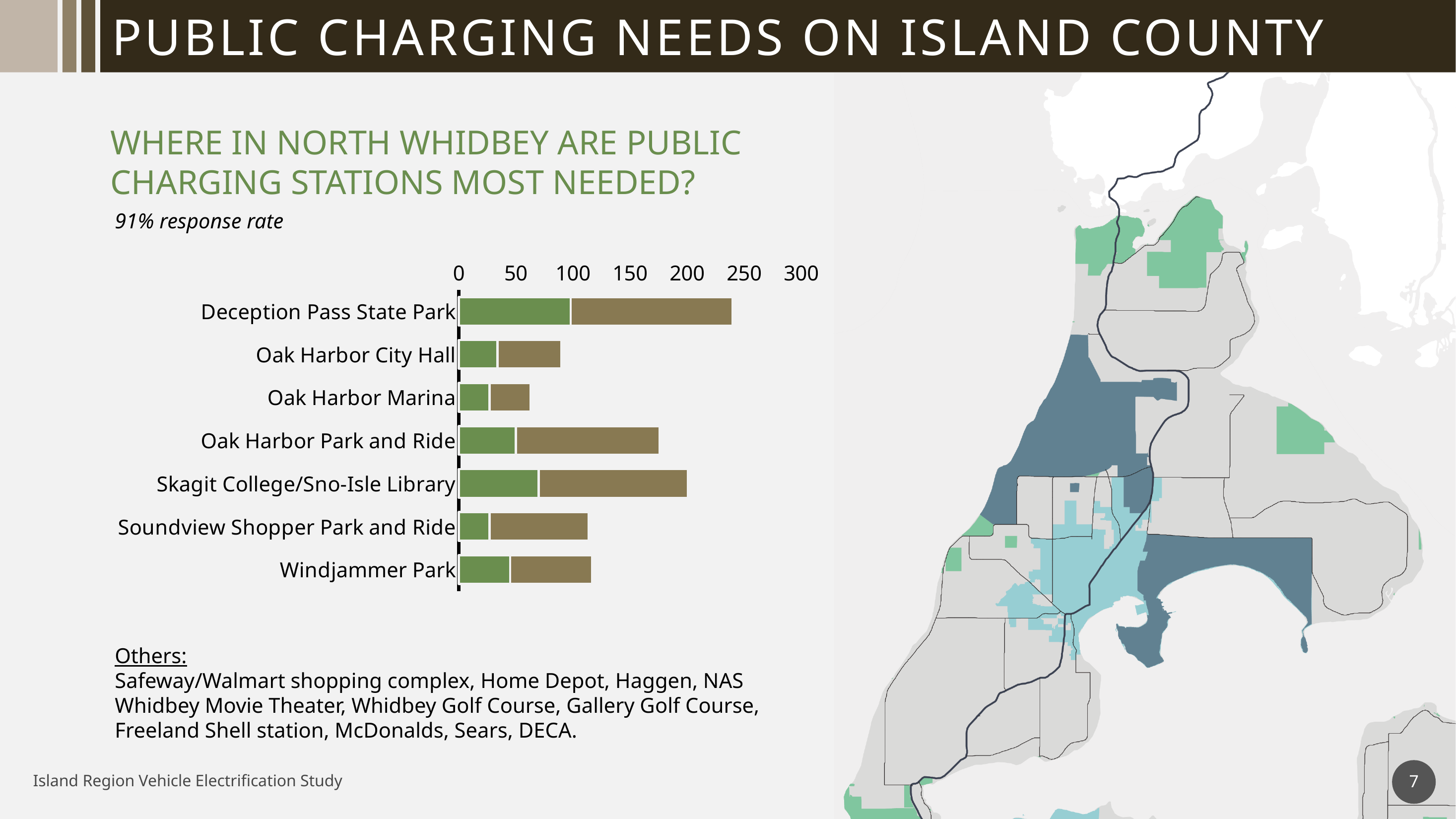
Is the total bar length for Oak Harbor City Hall greater or less than 100? less What response rate is stated below the chart's question heading? 91% response rate How many locations are listed on the chart? 7 Is the total bar length for Deception Pass State Park greater or less than 200? greater Which location has the shortest bar on the chart? Oak Harbor Marina Which location has the longest bar on the chart? Deception Pass State Park What kind of chart is shown on the slide? bar chart Which has the longer bar, Oak Harbor City Hall or Oak Harbor Marina? Oak Harbor City Hall Is the total bar length for Windjammer Park greater or less than 150? less Which has the longer bar, Skagit College/Sno-Isle Library or Oak Harbor Park and Ride? Skagit College/Sno-Isle Library